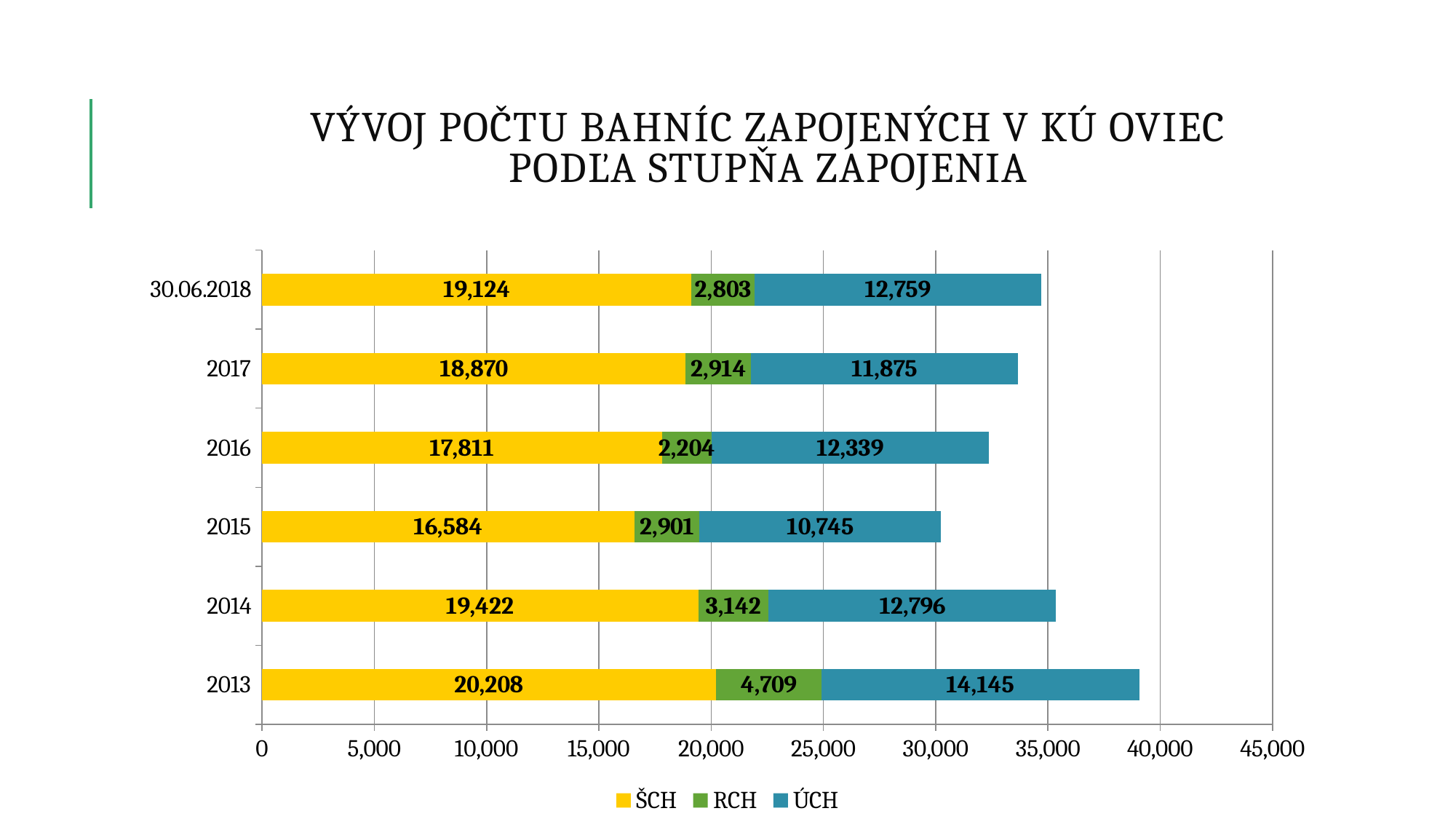
What kind of chart is shown on the slide? Stacked bar chart What is the total of the stacked bar for 2015? 30,230 Which is larger, the ŠCH value for 2017 or the ŠCH value for 2014? 2014 What is the ŠCH value for 2016? 17,811 How many series does the legend list? 3 Which year has the highest ŠCH value? 2013 What is the total of the stacked bar for 2013? 39,062 Which year has the lowest RCH value? 2016 How many categories (years) are shown on the chart? 6 What is the RCH value for 30.06.2018? 2,803 What is the ÚCH value for 2015? 10,745 What is the difference between the ÚCH values for 2013 and 2014? 1,349